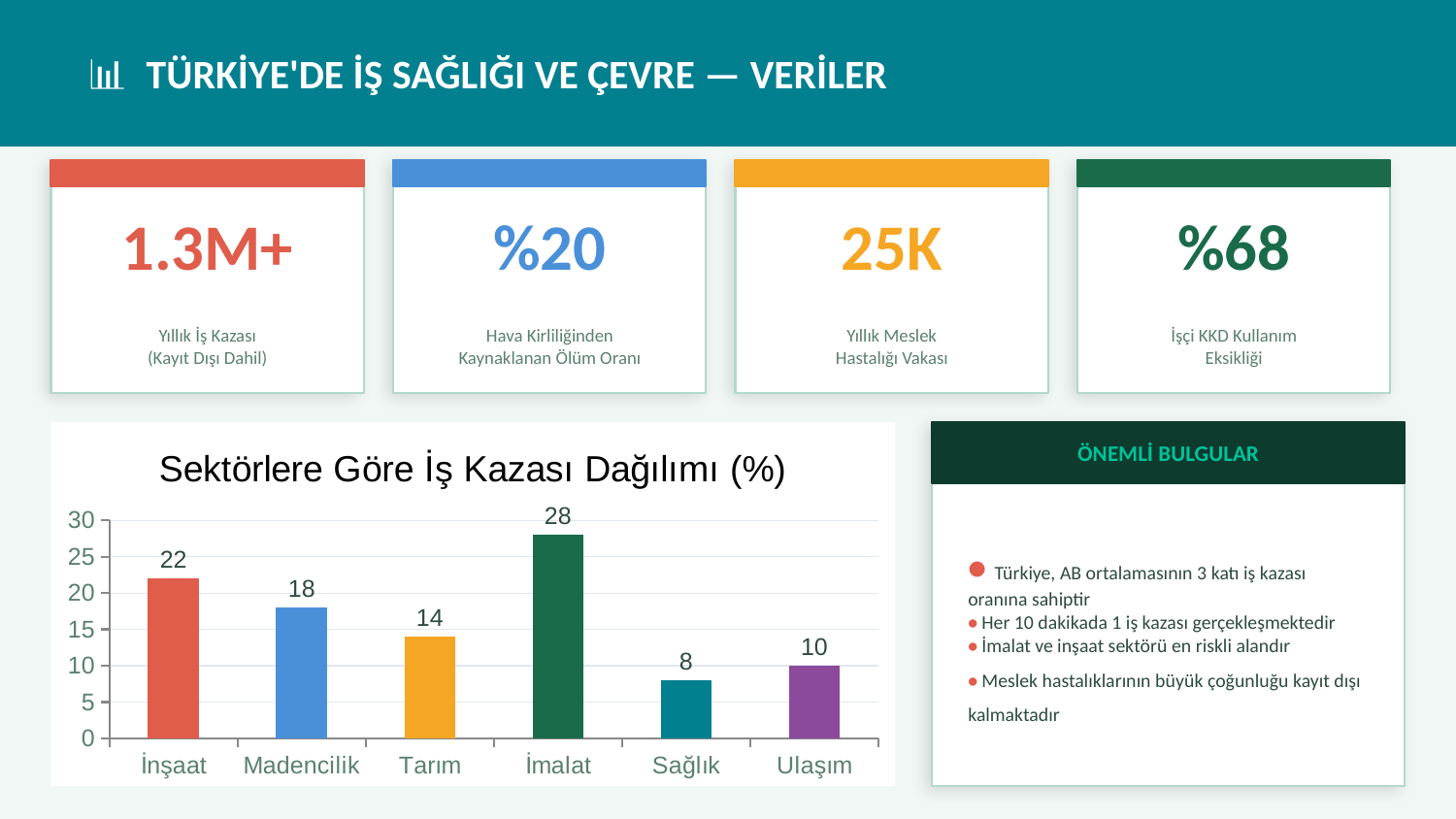
What is the value for Madencilik in the chart? 18 Which sector has the lowest value in the chart? Sağlık Which is larger, the value for İnşaat or the value for Madencilik? İnşaat What is the title of the chart? Sektörlere Göre İş Kazası Dağılımı (%) What kind of chart is shown on the slide? bar chart What is the difference between the values for Tarım and Ulaşım? 4 How many sectors are shown in the chart? 6 What is the difference between the values for İmalat and İnşaat? 6 Is the value for Tarım greater or less than 15? less What is the value for İmalat in the chart? 28 Which sector has the highest value in the chart? İmalat What is the value for Sağlık in the chart? 8